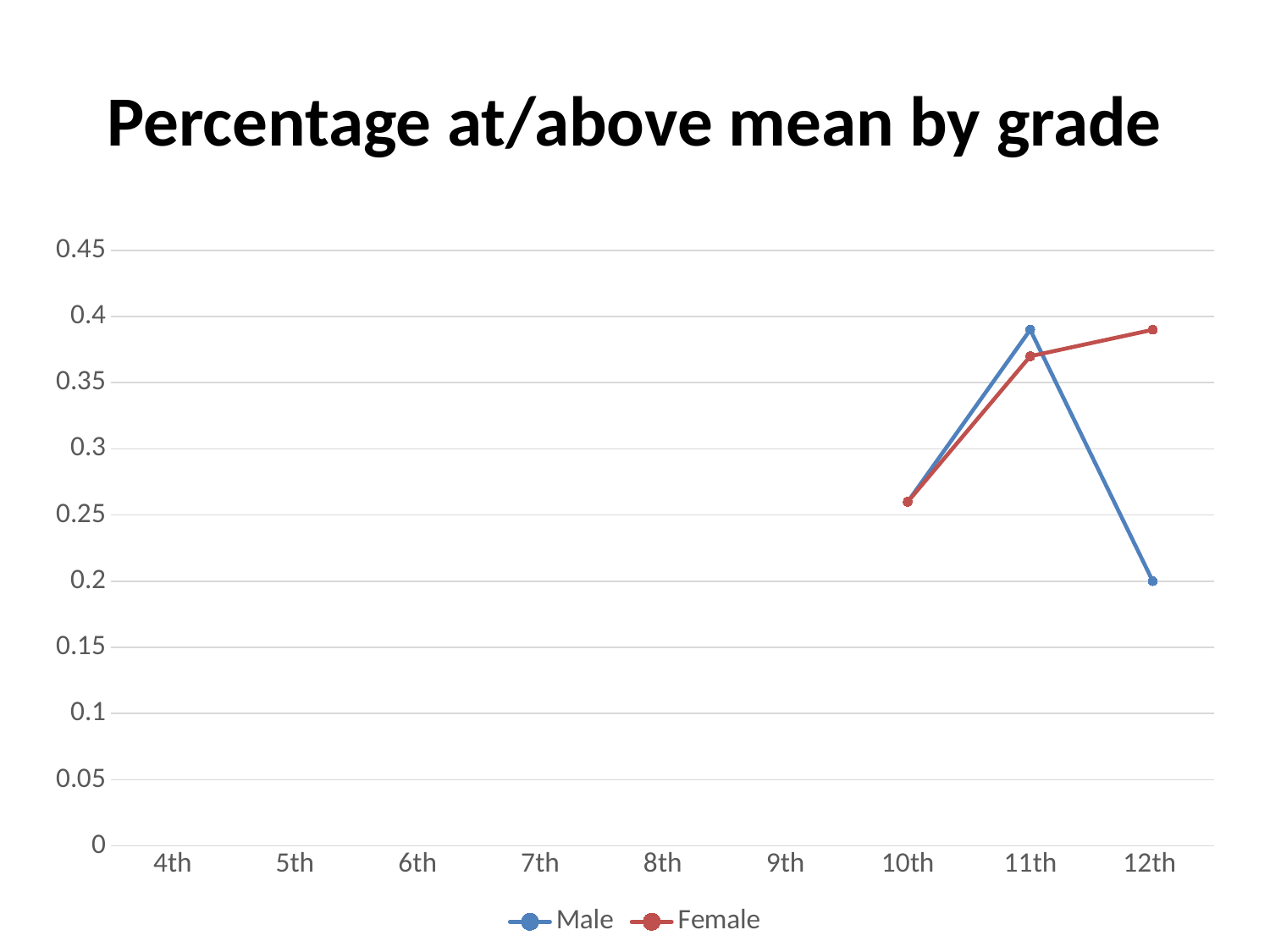
Is the value for Female at 10th grade greater or less than 0.3? less At which grade is the Male value lowest? 12th At 12th grade, which series has the larger value, Male or Female? Female Is the value for Female at 12th grade greater or less than 0.35? greater At which grade is the Female value lowest? 10th What is the value for Male at 12th grade? 0.2 How many series does the legend list? 2 At which grade is the Male value highest? 11th How many grade categories are shown on the x axis? 9 Does the Female series rise or fall from 10th grade to 12th grade? rise Is the value for Male at 11th grade greater or less than 0.35? greater What kind of chart is shown on the slide? line chart